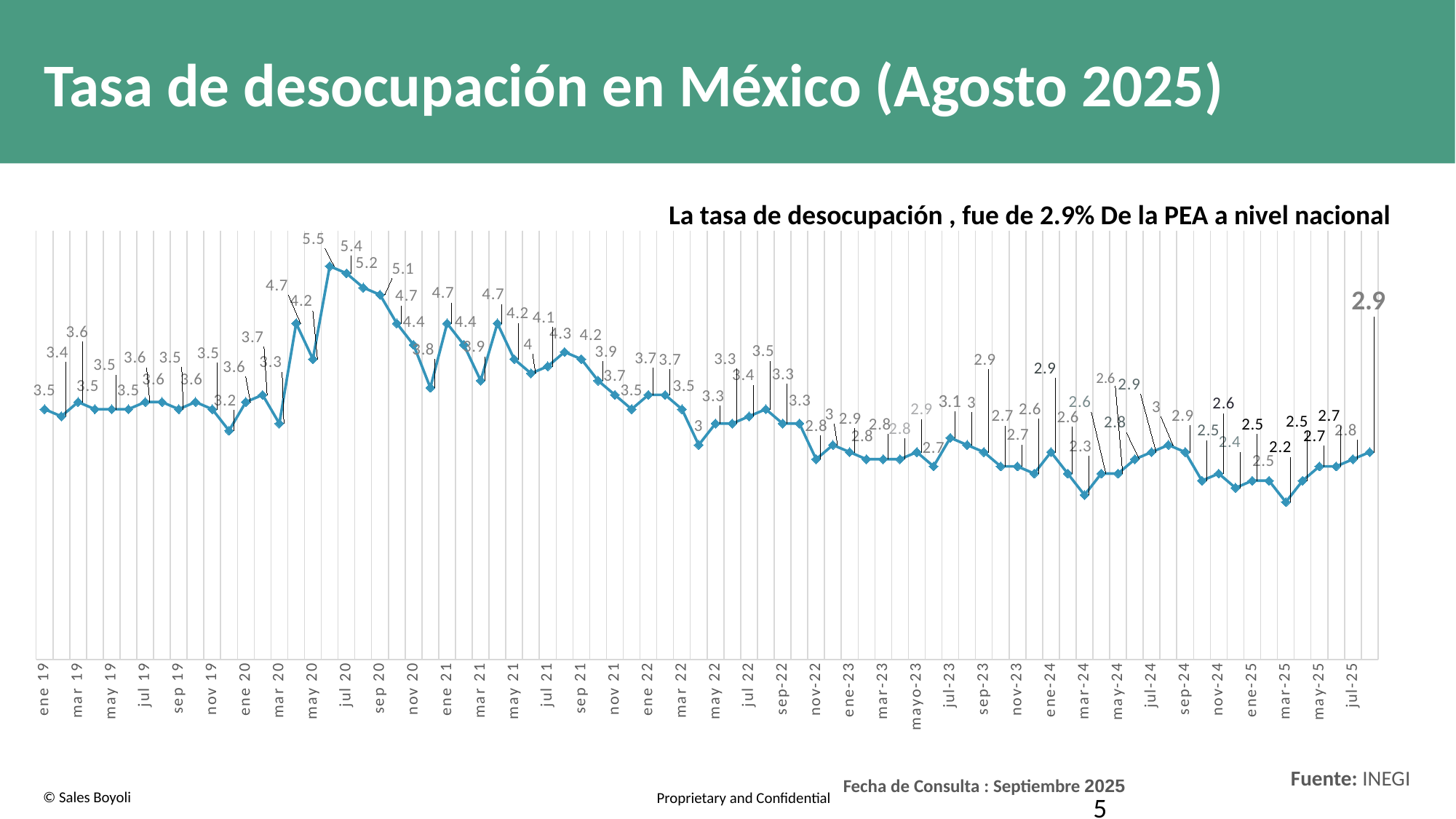
What is the lowest unemployment rate value plotted on the chart? 2.2 What is the value of the last data point on the chart (August 2025)? 2.9 What is the title of the slide? Tasa de desocupación en México (Agosto 2025) From the peak in mid-2020 to 2025, do the values generally rise or fall? fall In which month does the chart reach its lowest value? mar-25 What is the value for mar-25? 2.2 What is the difference between the highest value (5.5) and the lowest value (2.2) on the chart? 3.3 What is the highest unemployment rate value plotted on the chart? 5.5 Which is larger, the value for ene 19 or the final value for August 2025? ene 19 What is the value for ene 19, the first point on the chart? 3.5 What is the difference between the value for ene 19 and the final value for August 2025? 0.6 What kind of chart is shown on the slide? line chart